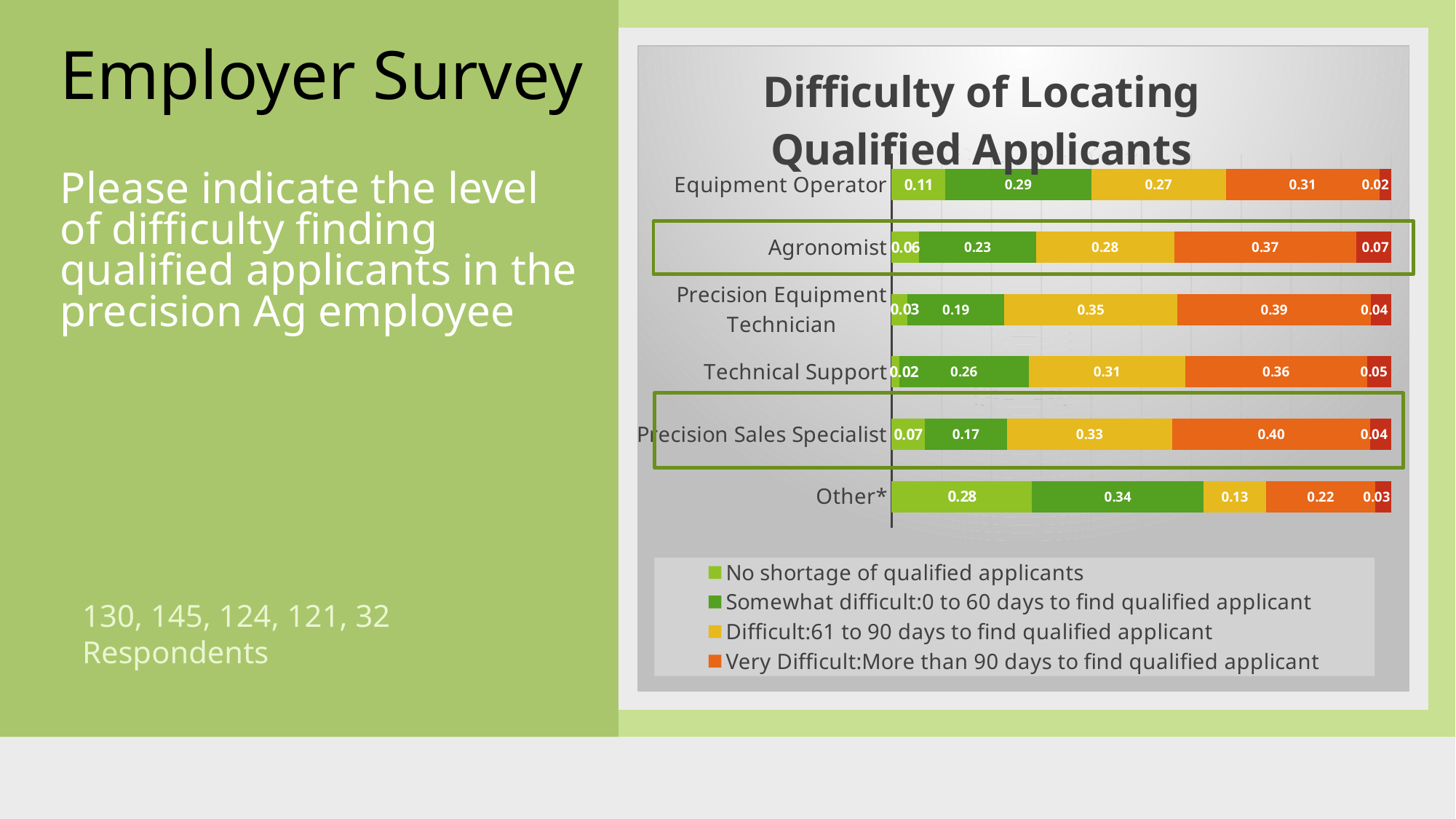
Which category has the highest 'No shortage of qualified applicants' value? Other* Which is larger: the 'Very Difficult' value for Agronomist or for Equipment Operator? Agronomist Which category has the highest 'Very Difficult' value? Precision Sales Specialist What is the difference between the 'Somewhat difficult' values for Other* and Precision Sales Specialist? 0.17 What is the 'No shortage of qualified applicants' value for Equipment Operator? 0.11 What is the 'Very Difficult' value for Precision Sales Specialist? 0.40 What kind of chart is shown on the slide? Stacked bar chart Which category has the lowest 'No shortage of qualified applicants' value? Technical Support How many series does the chart legend list? 4 What is the 'Difficult: 61 to 90 days' value for Precision Equipment Technician? 0.35 How many job categories are shown in the chart? 6 What is the title of the chart? Difficulty of Locating Qualified Applicants